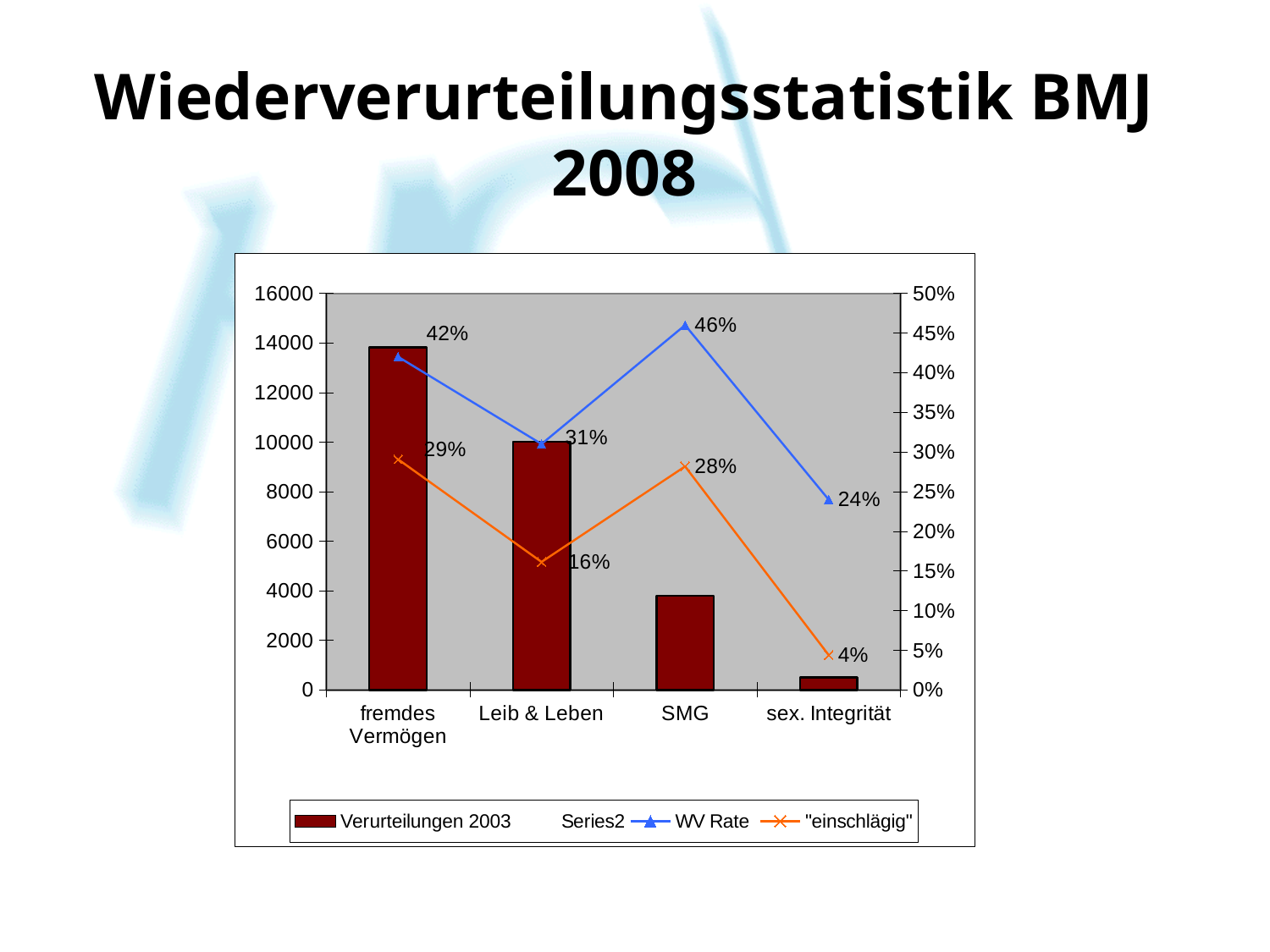
What kind of chart is shown on the slide? Combination bar and line chart What is the WV Rate for sex. Integrität? 24% Which category has the highest WV Rate? SMG What is the "einschlägig" value for Leib & Leben? 16% What is the WV Rate for SMG? 46% Is the Verurteilungen 2003 value for fremdes Vermögen greater or less than 12000? greater How many categories are shown on the x axis? 4 Which is larger, the WV Rate for fremdes Vermögen or the WV Rate for Leib & Leben? fremdes Vermögen What is the difference between the WV Rate and the "einschlägig" value for fremdes Vermögen? 13% Which category has the lowest "einschlägig" value? sex. Integrität Is the Verurteilungen 2003 value for SMG greater or less than 6000? less How many series does the legend list? 4